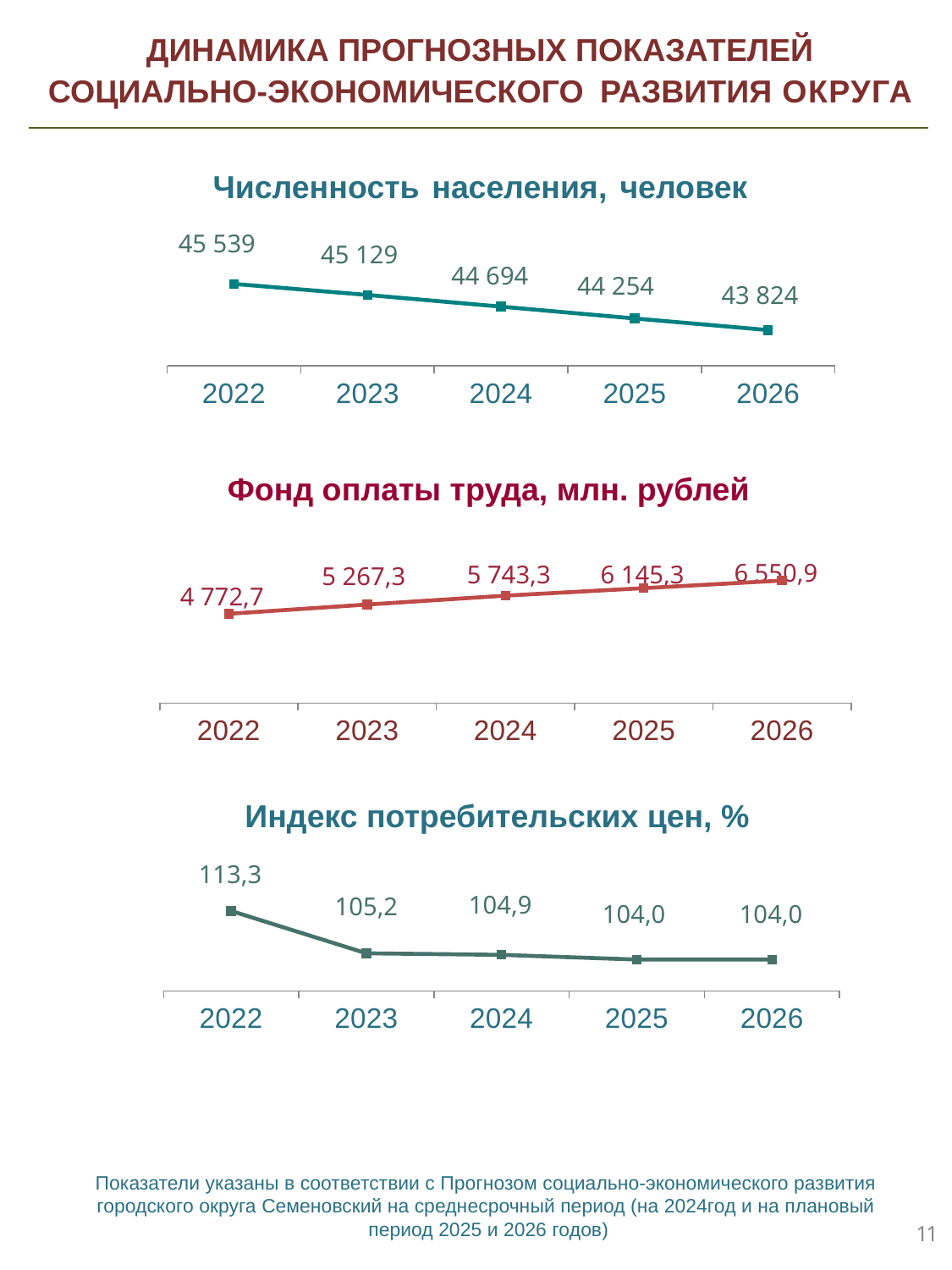
In the chart 'Индекс потребительских цен, %', what is the difference between the 2022 and 2023 values? 8,1 In the chart 'Численность населения, человек', do the values rise or fall from 2022 to 2026? fall In the chart 'Численность населения, человек', what is the difference between the 2022 and 2026 values? 1 715 In the chart 'Численность населения, человек', which year has the lowest value? 2026 What type of chart is 'Индекс потребительских цен, %'? line chart In the chart 'Индекс потребительских цен, %', which is larger, the value for 2023 or the value for 2025? 2023 In the chart 'Фонд оплаты труда, млн. рублей', what is the value for 2023? 5 267,3 In the chart 'Фонд оплаты труда, млн. рублей', how many data points are plotted? 5 In the chart 'Фонд оплаты труда, млн. рублей', which year has the highest value? 2026 In the chart 'Индекс потребительских цен, %', what is the value for 2022? 113,3 In the chart 'Фонд оплаты труда, млн. рублей', what is the difference between the 2026 and 2022 values? 1 778,2 In the chart 'Численность населения, человек', what is the value for 2024? 44 694